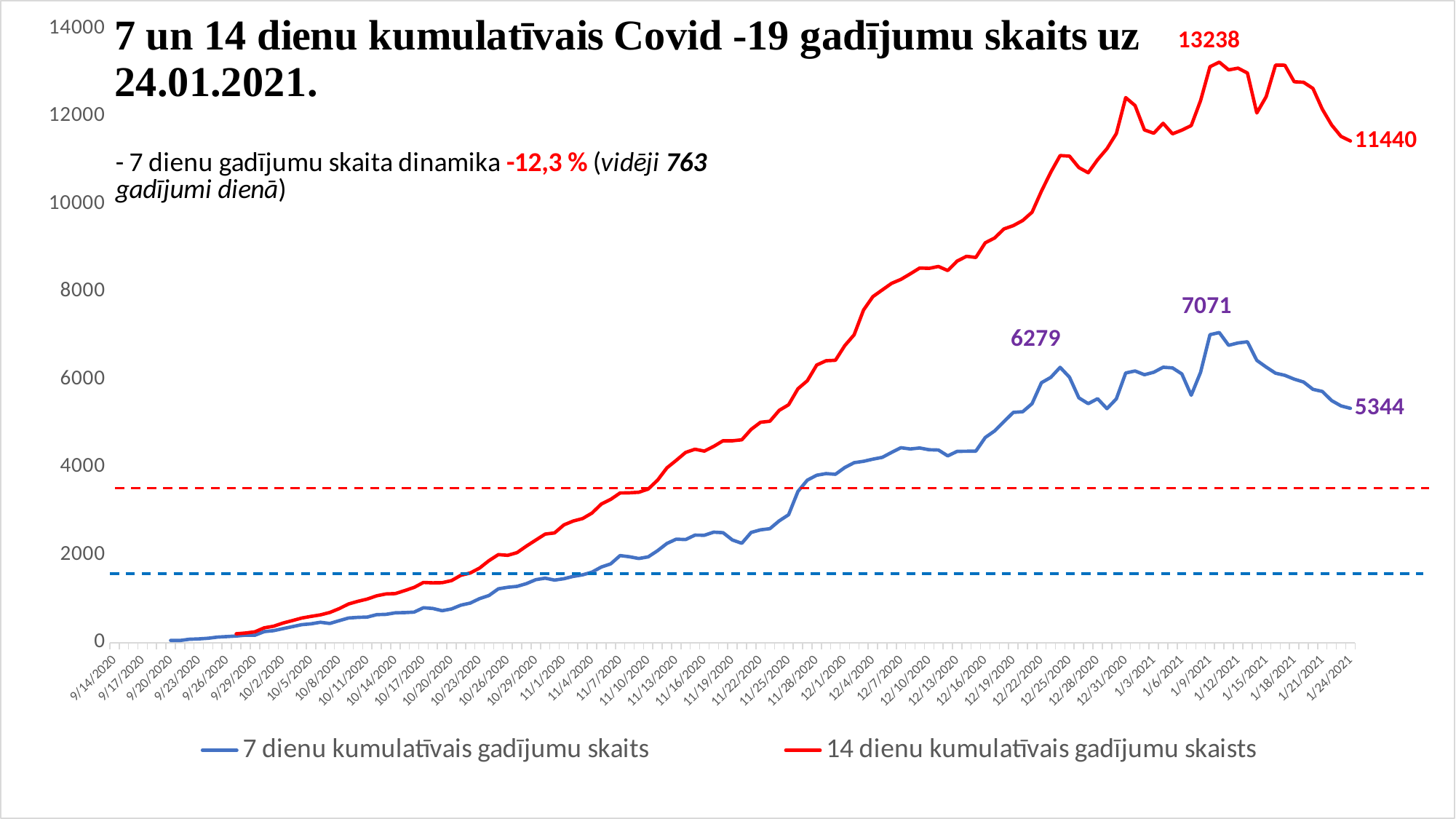
What is the difference between the two labelled peaks of the 7-day series, 7071 and 6279? 792 What kind of chart is shown on the slide? line chart What is the last labelled value of the 7 dienu kumulatīvais gadījumu skaits series, at 1/24/2021? 5344 At 1/24/2021, which series has the larger value: the 7-day or the 14-day cumulative count? 14 dienu kumulatīvais gadījumu skaists What is the difference between the peak value 13238 and the final value 11440 of the 14-day series? 1798 Is the value of the 14 dienu kumulatīvais gadījumu skaists series on 12/1/2020 greater or less than 6000? greater Is the value of the 7 dienu kumulatīvais gadījumu skaits series on 11/1/2020 greater or less than 2000? less What is the last labelled value of the 14 dienu kumulatīvais gadījumu skaists series, at 1/24/2021? 11440 How many series does the legend list? 2 Does the 7 dienu kumulatīvais gadījumu skaits series rise or fall between 1/9/2021 and 1/24/2021? fall What is the highest labelled value of the 7 dienu kumulatīvais gadījumu skaits series? 7071 What is the highest labelled value of the 14 dienu kumulatīvais gadījumu skaists series? 13238